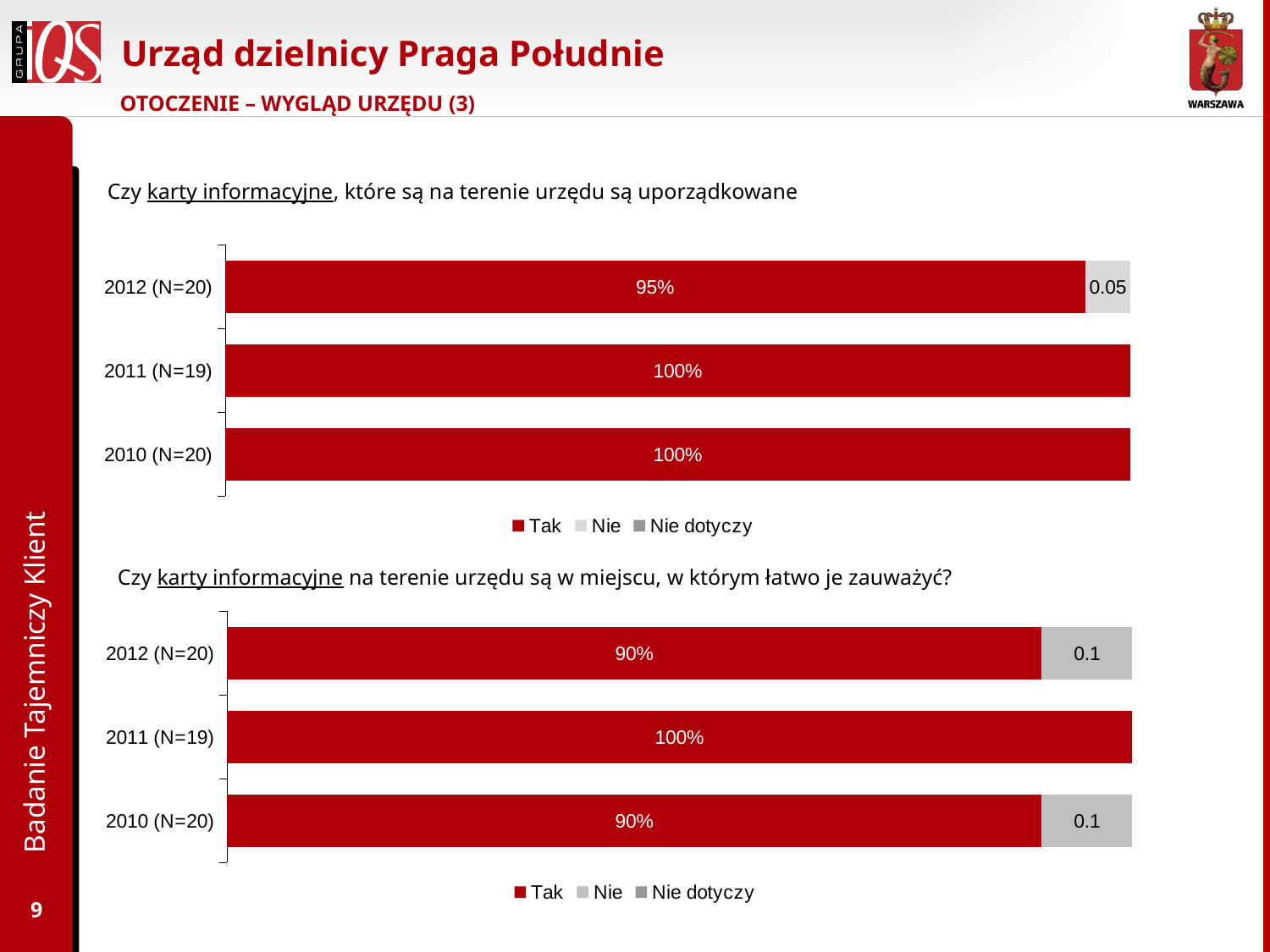
In the bottom chart, what is the difference between the 'Tak' values for 2011 (N=19) and 2012 (N=20)? 10% In the bottom chart, what label is shown on the grey 'Nie' segment for 2012 (N=20)? 0.1 In the top chart, what label is shown on the grey 'Nie' segment for 2012 (N=20)? 0.05 How many series does the legend of the top chart list? 3 How many year categories are shown in the bottom chart? 3 In the bottom chart, what is the 'Tak' value for 2011 (N=19)? 100% In the top chart, what is the 'Tak' value for 2012 (N=20)? 95% In the top chart, which year has the lowest 'Tak' value? 2012 (N=20) What type of chart is the top chart? Bar chart In the top chart, what is the 'Tak' value for 2011 (N=19)? 100% In the bottom chart, what is the 'Tak' value for 2010 (N=20)? 90% In the bottom chart, which year has the highest 'Tak' value? 2011 (N=19)